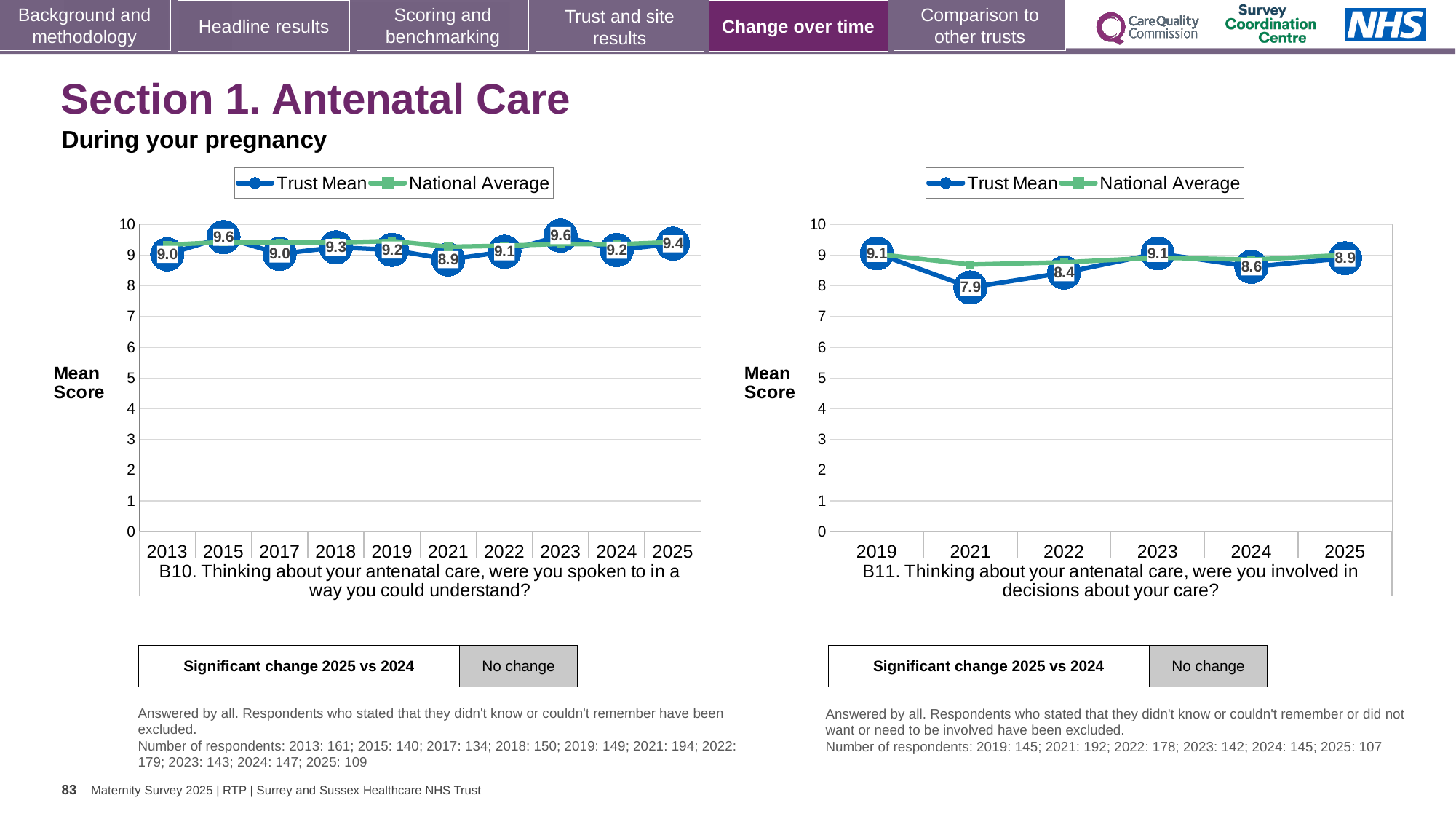
How many years are plotted on the x axis of the B10 chart (left)? 10 In the B11 chart (right), what is the difference between the Trust Mean for 2025 and 2021? 1.0 How many series does the legend of the B11 chart (right) list? 2 In the B11 chart (right), what is the Trust Mean for 2021? 7.9 In the B10 chart (left), what is the difference between the Trust Mean for 2023 and 2024? 0.4 In the B11 chart (right), is the Trust Mean for 2022 larger or smaller than the Trust Mean for 2024? smaller What type of chart is the B10 chart (left)? Line chart In the B10 chart (left), what is the Trust Mean for 2021? 8.9 In the B10 chart (left), which year has the lowest Trust Mean? 2021 In the B10 chart (left), what is the Trust Mean for 2025? 9.4 In the B11 chart (right), which year has the lowest Trust Mean? 2021 In the B11 chart (right), is the Trust Mean for 2021 greater or less than 8? less